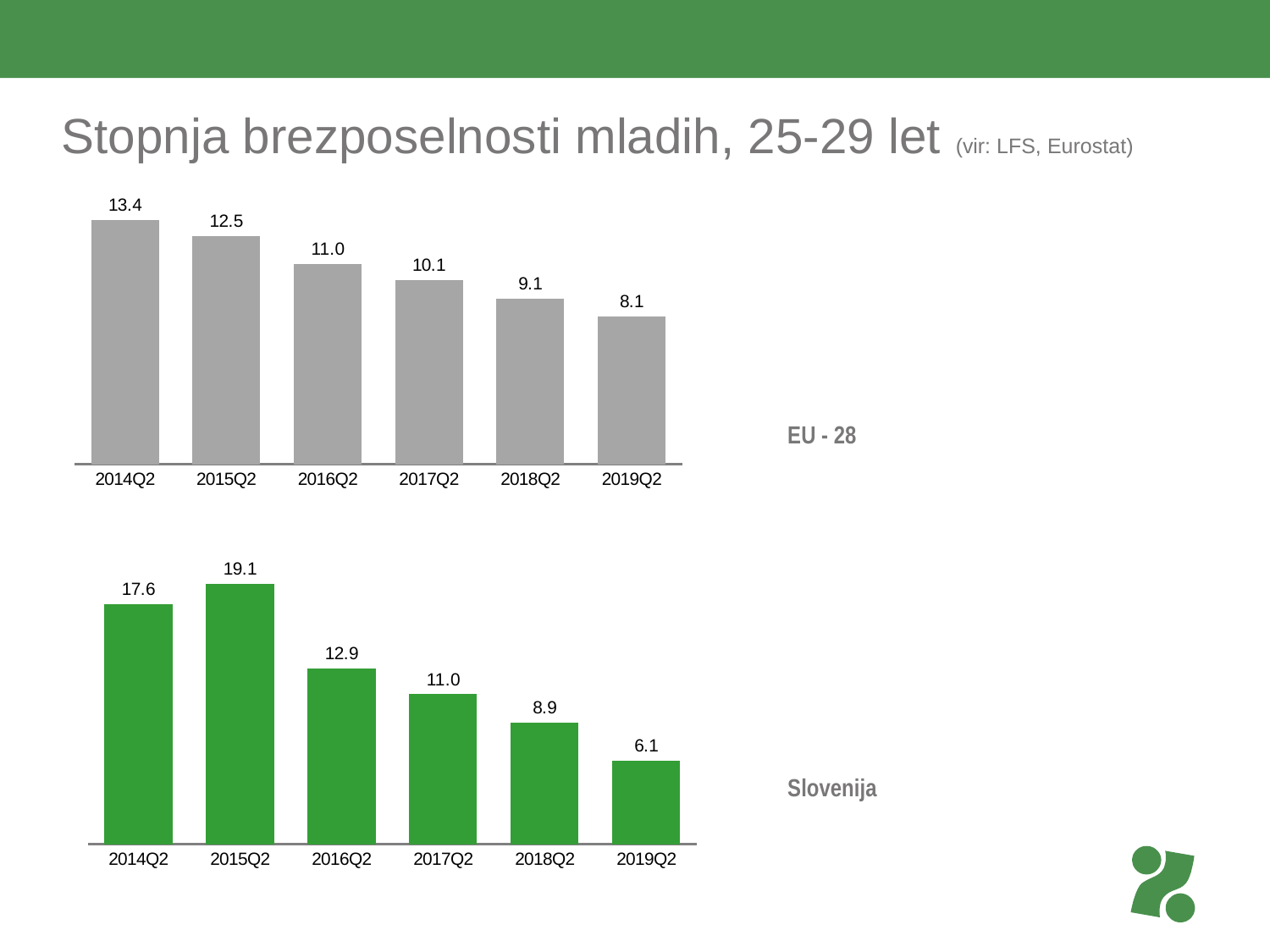
In the EU - 28 chart, what is the value for 2014Q2? 13.4 In the EU - 28 chart, what is the difference between the values for 2014Q2 and 2019Q2? 5.3 In the Slovenija chart, what is the difference between the values for 2015Q2 and 2016Q2? 6.2 What kind of chart is the EU - 28 chart? Bar chart Which is larger: the 2017Q2 value in the EU - 28 chart or the 2017Q2 value in the Slovenija chart? They are equal (11.0) In the EU - 28 chart, which quarter has the lowest value? 2019Q2 In the Slovenija chart, which quarter has the highest value? 2015Q2 In the Slovenija chart, what is the value for 2015Q2? 19.1 In the EU - 28 chart, what is the value for 2019Q2? 8.1 In the Slovenija chart, what is the value for 2018Q2? 8.9 In the EU - 28 chart, do the values rise or fall from 2014Q2 to 2019Q2? Fall How many quarters are shown in the Slovenija chart? 6